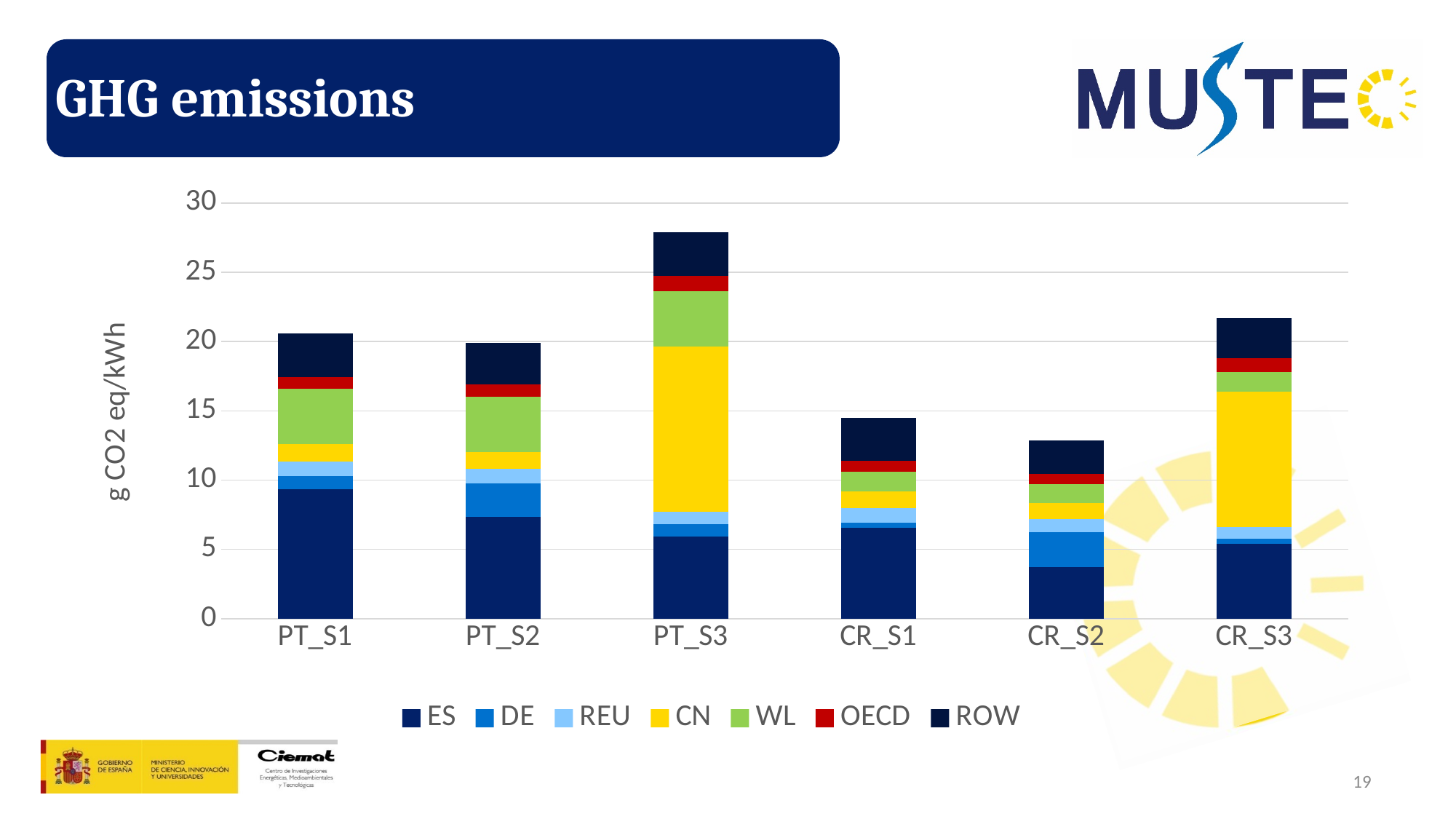
Which series is shown in yellow in the chart legend? CN Is the total value for CR_S2 greater or less than 15? less Is the total value for CR_S1 greater or less than 15? less Which category has the lowest total stacked bar? CR_S2 What kind of chart is shown on the slide? stacked bar chart How many categories are shown on the x axis of the chart? 6 Which has a larger total stacked bar, PT_S1 or CR_S1? PT_S1 Is the total value for CR_S3 greater or less than 20? greater What is the label of the y axis of the chart? g CO2 eq/kWh How many series does the chart legend list? 7 Which category has the highest total stacked bar? PT_S3